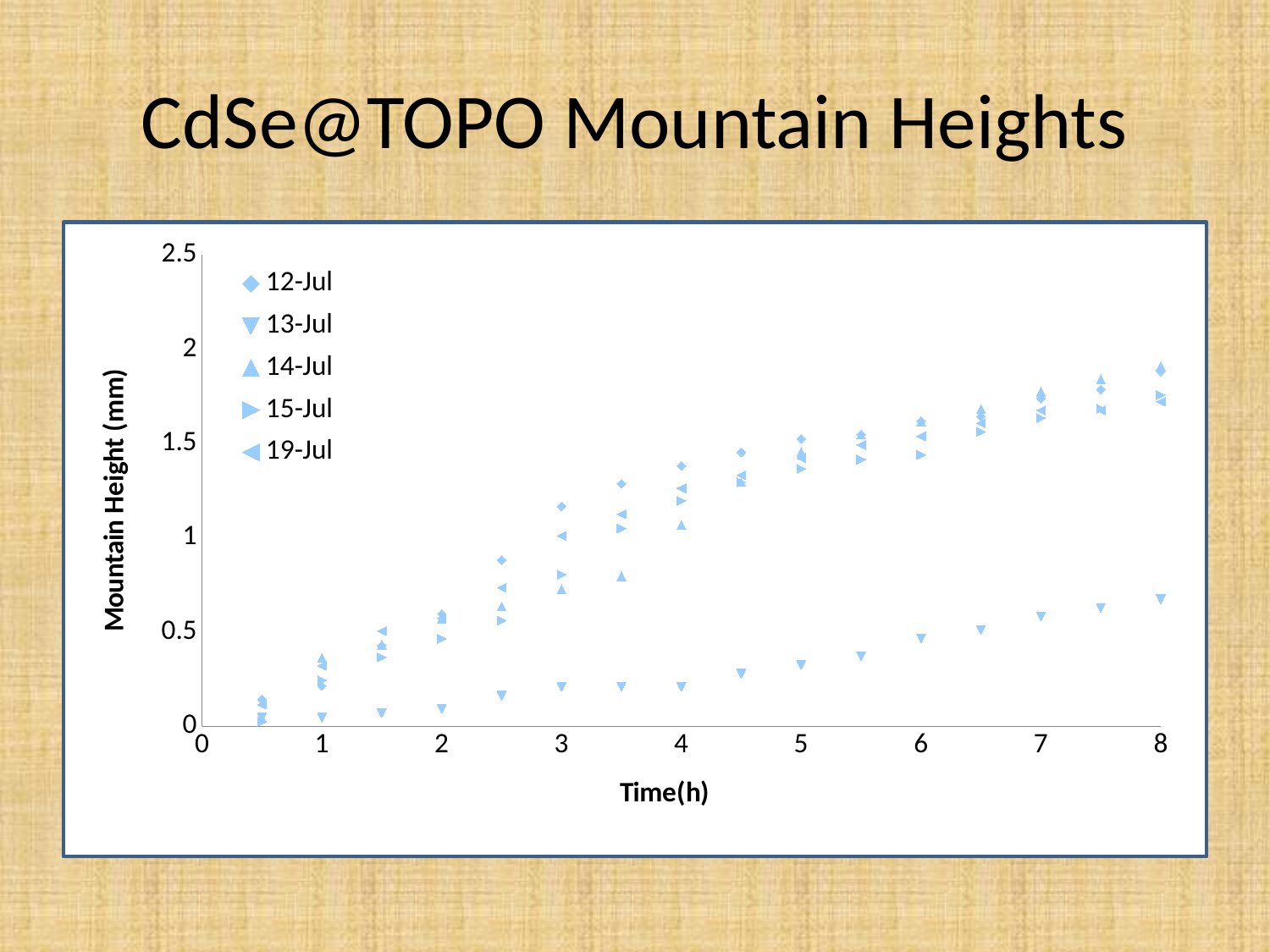
At 8 h, which series has the larger mountain height, 12-Jul or 13-Jul? 12-Jul Is the mountain height for 13-Jul at 8 h greater or less than 1? less What is the label of the y axis? Mountain Height (mm) Do the mountain heights rise or fall as time increases? Rise Is the mountain height for 13-Jul at 4 h greater or less than 0.5? less What is the title of the chart? CdSe@TOPO Mountain Heights What kind of chart is shown on the slide? Scatter chart Is the mountain height for 12-Jul at 3 h greater or less than 1? greater Which series has the lowest mountain heights across the time range? 13-Jul How many series does the legend list? 5